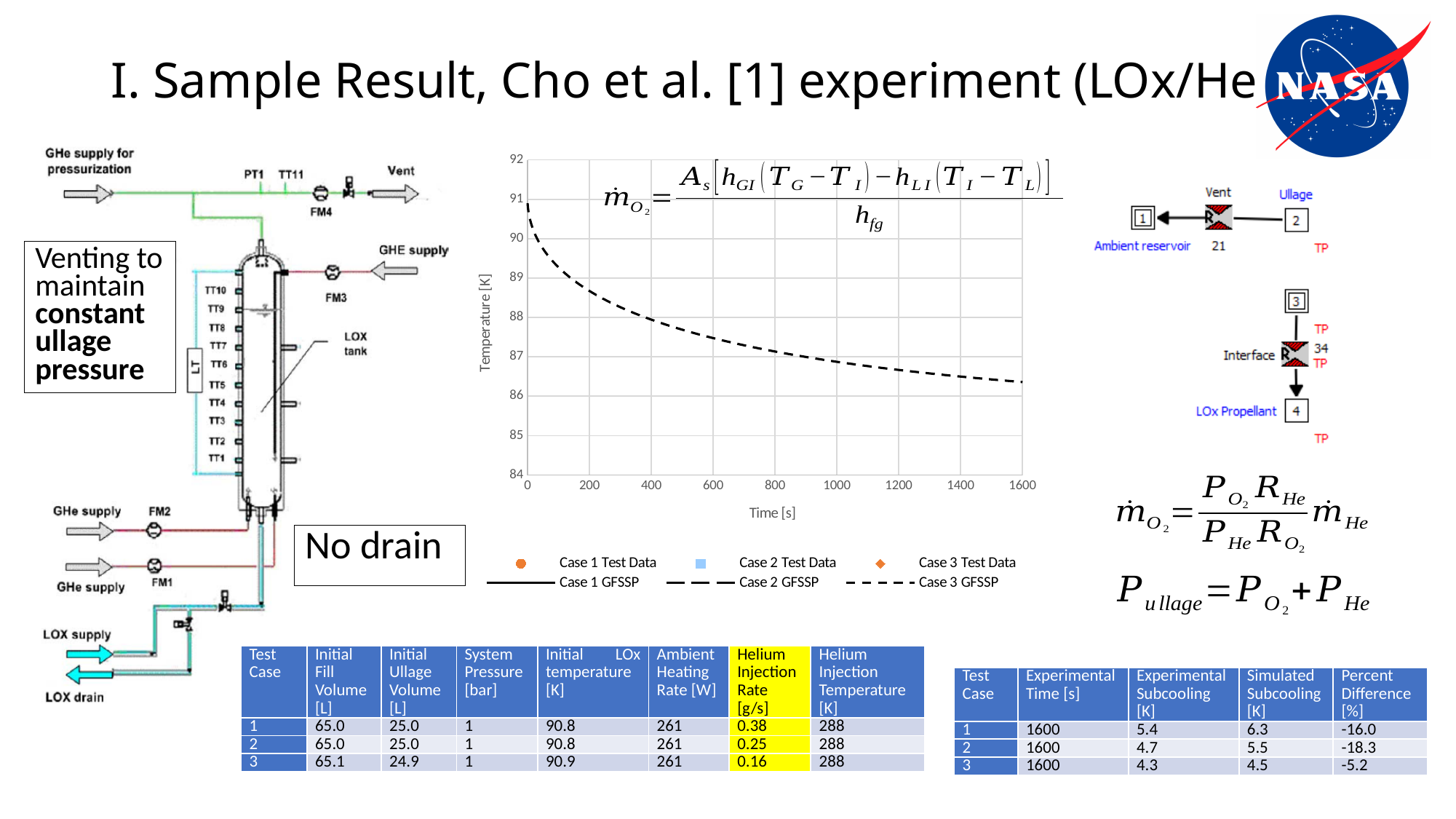
In the Temperature vs Time chart, is the temperature at 1000 s greater or less than 88? less In the Temperature vs Time chart, is the temperature at 400 s greater or less than 89? less In the Temperature vs Time chart, is the temperature at 0 s greater or less than 90? greater What is the label of the x axis of the Temperature chart? Time [s] Which legend entry of the Temperature vs Time chart is drawn as a short-dashed line? Case 3 GFSSP In the Temperature vs Time chart, does the plotted temperature rise or fall as time increases? fall What kind of chart is shown in the middle of the slide, plotting Temperature [K] against Time [s]? line chart How many series does the legend of the Temperature vs Time chart list? 6